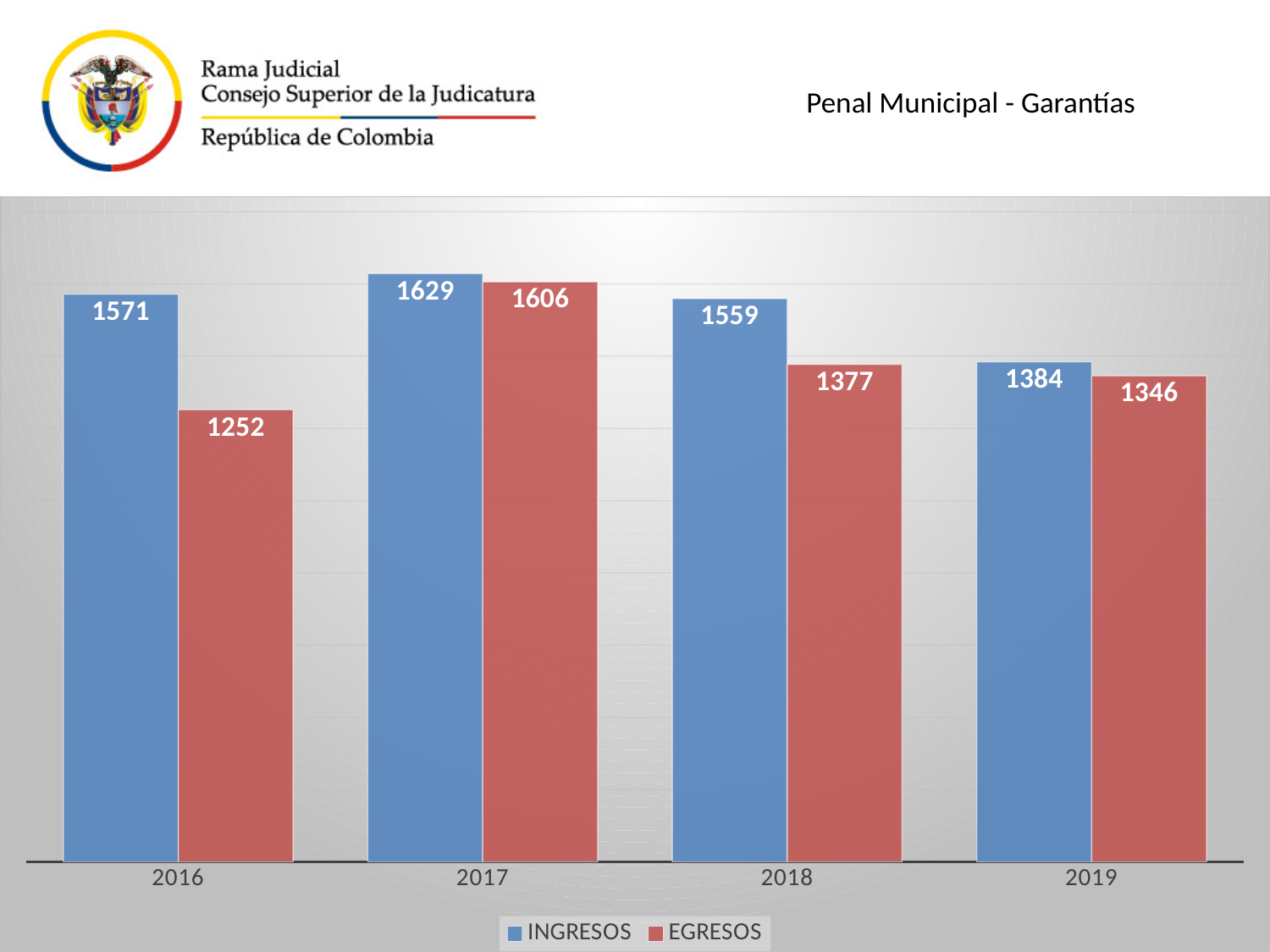
What is the EGRESOS value for 2016? 1252 Which is larger in 2018, INGRESOS or EGRESOS? INGRESOS What is the EGRESOS value for 2019? 1346 What is the difference between INGRESOS and EGRESOS in 2016? 319 Which year has the highest INGRESOS value? 2017 What is the difference between the INGRESOS values for 2018 and 2019? 175 How many years are shown on the x axis? 4 What is the INGRESOS value for 2017? 1629 How many series does the legend list? 2 What colour are the EGRESOS bars? Red Which year has the lowest EGRESOS value? 2016 What kind of chart is shown on the slide? Bar chart